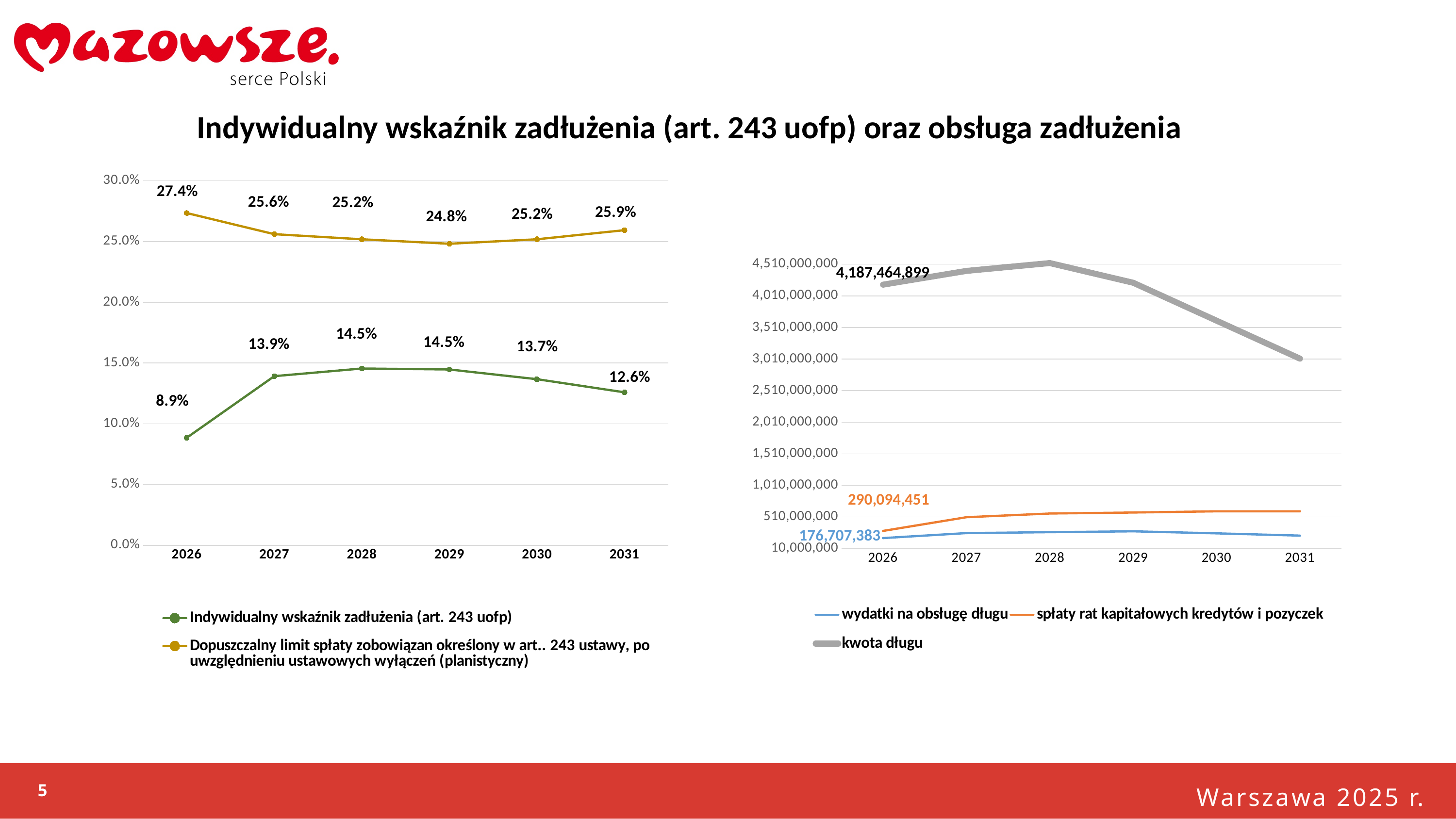
In the left chart, which is larger in 2027: the Indywidualny wskaźnik zadłużenia or the Dopuszczalny limit? Dopuszczalny limit In the left chart, what is the value of Indywidualny wskaźnik zadłużenia (art. 243 uofp) for 2026? 8.9% In the right chart, what is the value of wydatki na obsługę długu for 2026? 176,707,383 In the left chart, how many years are shown on the x axis? 6 In the left chart, what is the difference between the Dopuszczalny limit and the Indywidualny wskaźnik zadłużenia in 2031? 13.3% In the right chart, how many series does the legend list? 3 What kind of chart is the right chart? Line chart In the left chart, in which year is the Indywidualny wskaźnik zadłużenia (art. 243 uofp) lowest? 2026 In the left chart, in which year is the Dopuszczalny limit spłaty zobowiązań series highest? 2026 In the right chart, is the value of kwota długu for 2031 greater or less than 3,510,000,000? less In the left chart, what is the value of the Dopuszczalny limit spłaty zobowiązań series for 2029? 24.8% In the right chart, what is the value of kwota długu for 2026? 4,187,464,899